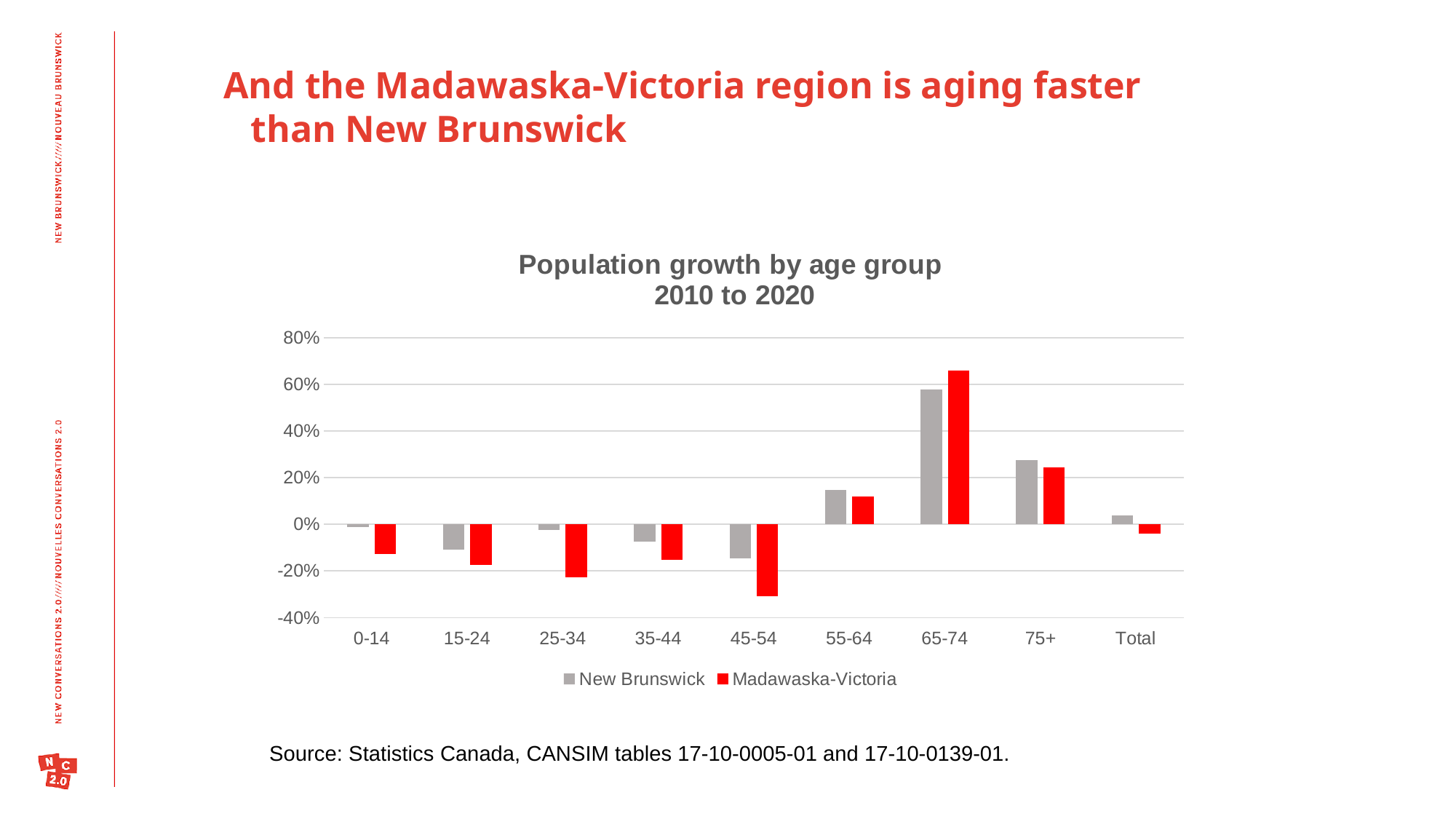
Which category has the lowest value for Madawaska-Victoria? 45-54 For the 45-54 age group, which series has the lower value, New Brunswick or Madawaska-Victoria? Madawaska-Victoria Is the Madawaska-Victoria value for the 45-54 age group greater or less than -20%? less Which category has the highest value for New Brunswick? 65-74 Which category has the highest value for Madawaska-Victoria? 65-74 Is the Madawaska-Victoria value for the 65-74 age group greater or less than 60%? greater What is the title of the chart? Population growth by age group 2010 to 2020 For the 65-74 age group, which series has the larger value, New Brunswick or Madawaska-Victoria? Madawaska-Victoria How many age-group categories (including Total) are shown on the x axis? 9 How many series does the legend list? 2 What kind of chart is shown on the slide? Bar chart Which category has the lowest value for New Brunswick? 45-54